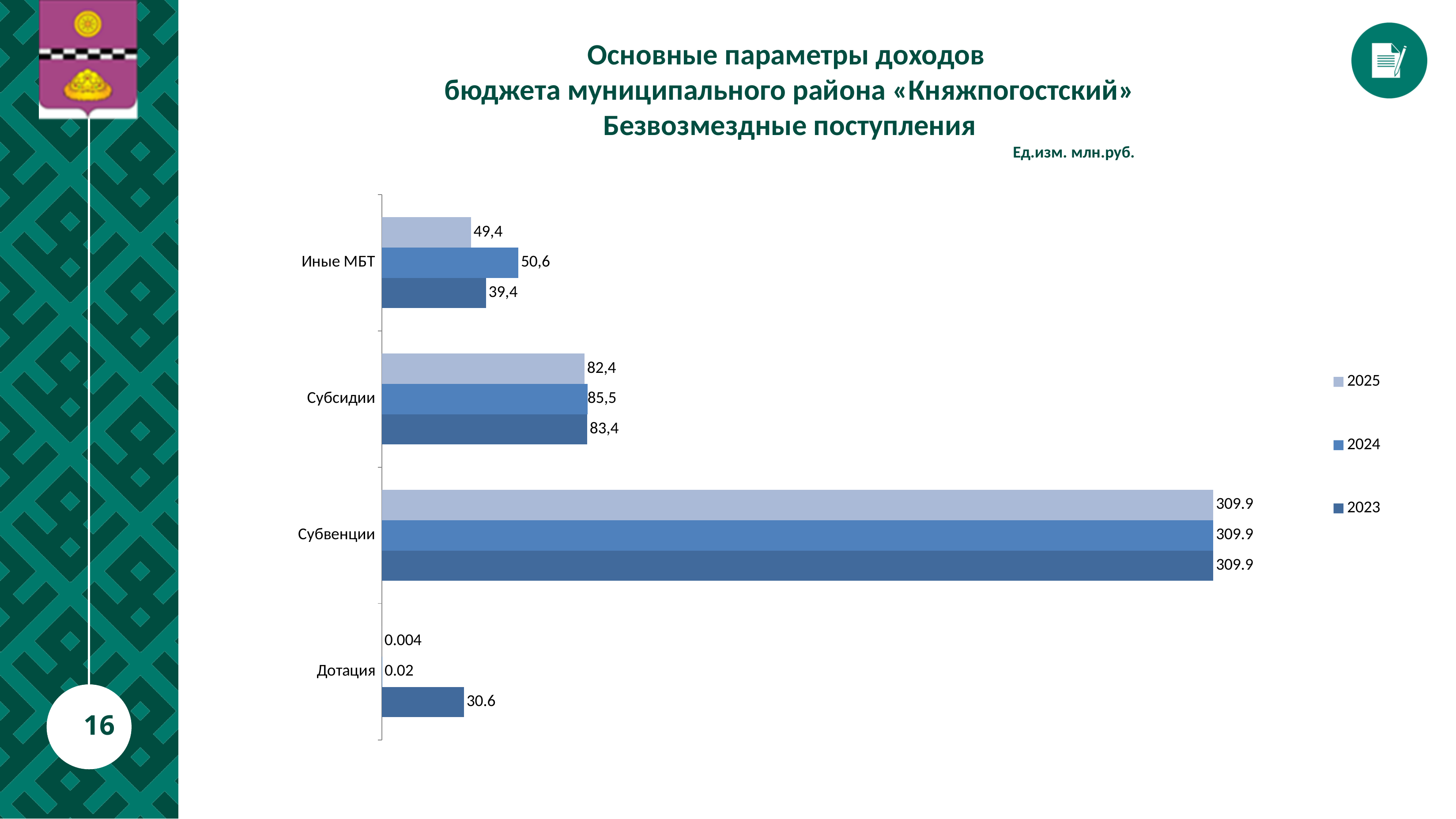
What unit of measurement is stated for the chart? млн.руб. Which category has the lowest value in 2025? Дотация Which is larger for Субсидии: the 2025 value or the 2023 value? 2023 What is the value for Субсидии in 2024? 85,5 Which category has the highest value in 2023? Субвенции What kind of chart is shown on the slide? Bar chart What is the value for Иные МБТ in 2023? 39,4 What is the value for Дотация in 2025? 0.004 What is the value for Субвенции in 2024? 309.9 How many series does the legend list? 3 How many categories are shown on the chart? 4 What is the difference between the 2024 and 2023 values for Иные МБТ? 11,2